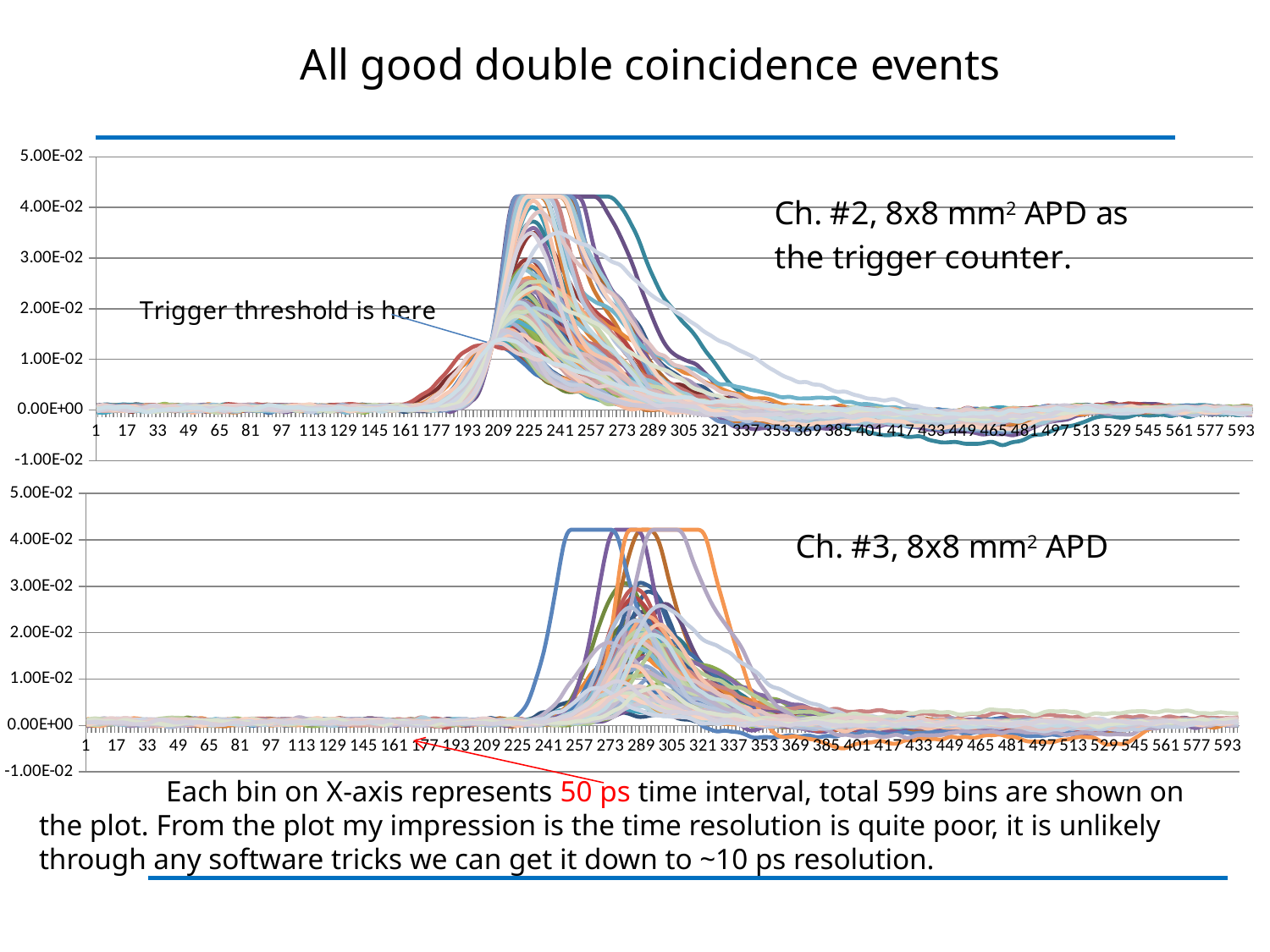
Comparing the two charts, do the waveforms in the top chart (Ch. #2) or the bottom chart (Ch. #3) peak at a larger x value? bottom chart (Ch. #3) In the bottom chart (Ch. #3), are the values at x = 97 greater or less than 1.00E-02? less In the bottom chart (Ch. #3), is the maximum value reached by the waveforms greater or less than 4.00E-02? greater What kind of chart is the top chart (Ch. #2)? line chart In the top chart (Ch. #2), are the values at x = 1 greater or less than 1.00E-02? less What kind of chart is the bottom chart (Ch. #3)? line chart How many charts are shown on the slide? 2 In the bottom chart (Ch. #3), do the waveforms rise or fall between x = 225 and x = 273? rise In the top chart (Ch. #2), what is the highest value labelled on the y axis? 5.00E-02 In the top chart (Ch. #2), do the waveforms rise or fall between x = 177 and x = 225? rise In the top chart (Ch. #2), do the waveforms rise or fall between x = 273 and x = 337? fall